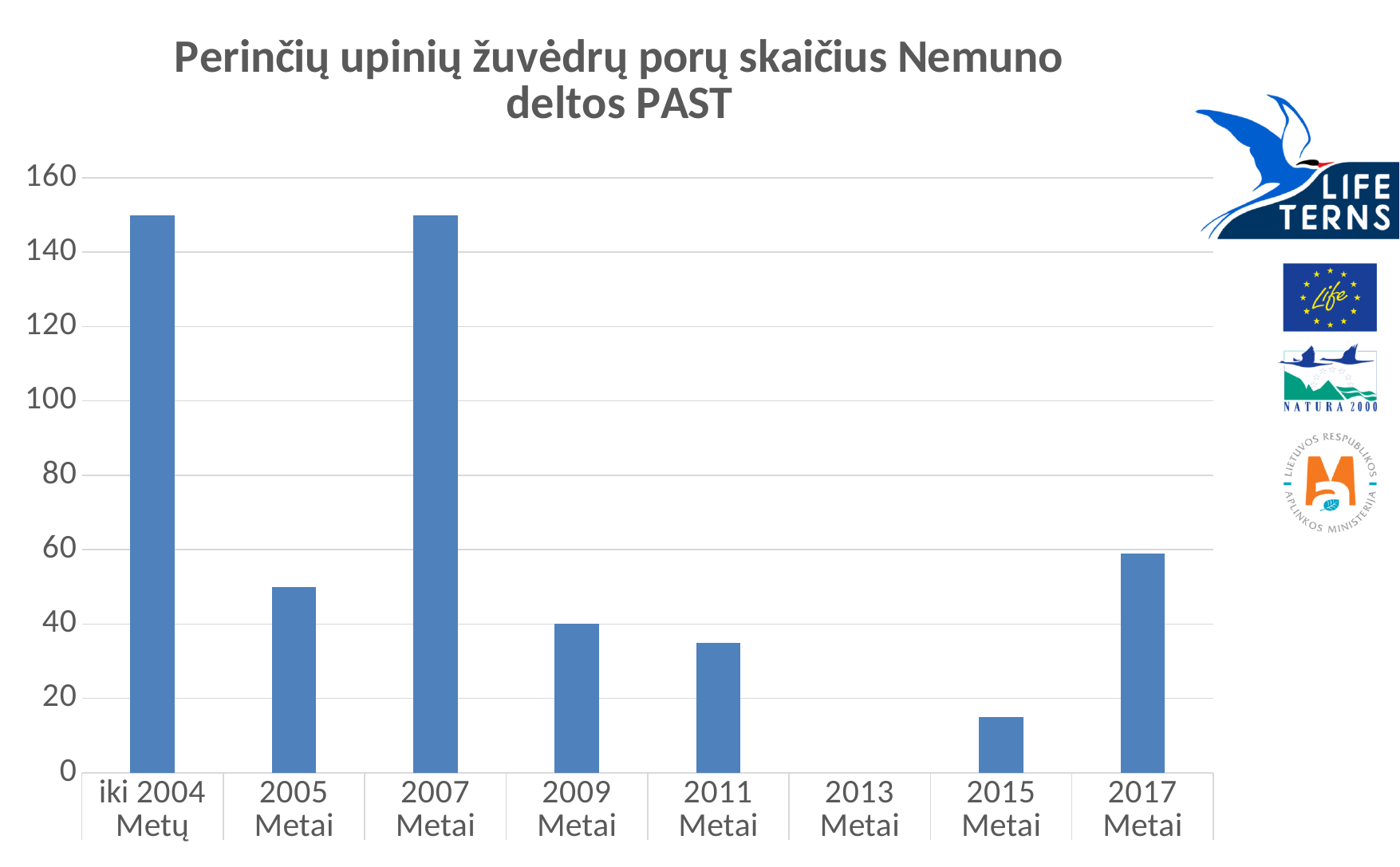
What is the title of the chart? Perinčių upinių žuvėdrų porų skaičius Nemuno deltos PAST Do the values rise or fall from 2007 Metai to 2011 Metai? fall Is the value for iki 2004 Metų greater or less than 140? greater Which is larger, the value for 2017 Metai or the value for 2011 Metai? 2017 Metai Which is larger, the value for 2005 Metai or the value for 2009 Metai? 2005 Metai Is the value for 2015 Metai greater or less than 20? less Is the value for 2005 Metai greater or less than 40? greater How many year categories are shown on the x axis? 8 What kind of chart is shown on the slide? bar chart